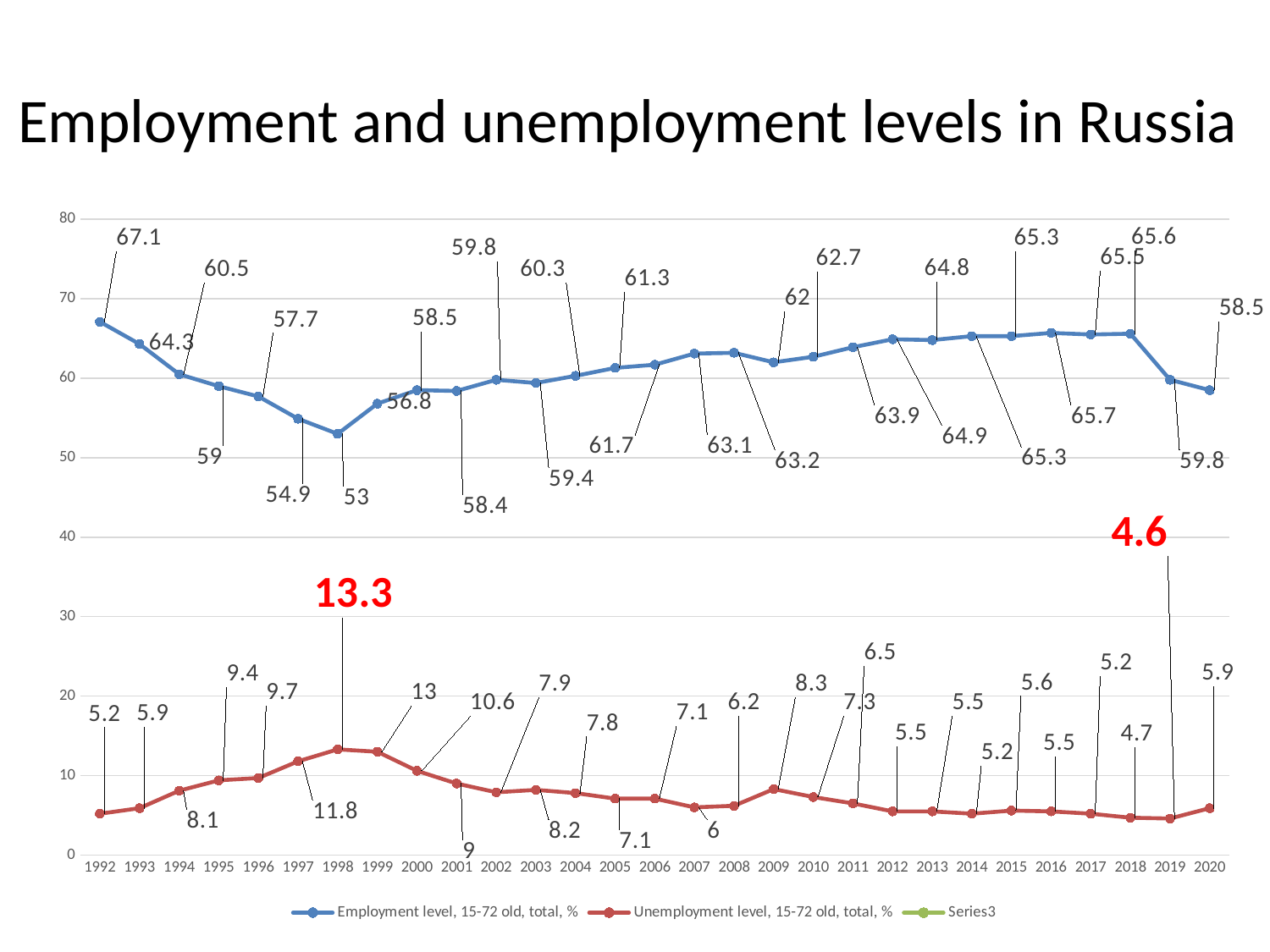
Did the employment level rise or fall from 1992 to 1998? Fall In which year was the employment level lowest? 1998 What was the unemployment level in 1998? 13.3 What kind of chart is shown on the slide? Line chart What was the unemployment level in 2020? 5.9 Which year had the higher unemployment level, 2008 or 2009? 2009 By how much did the unemployment level change from 2019 to 2020? 1.3 What was the employment level in Russia in 1992? 67.1 In which year was the unemployment level lowest? 2019 In which year was the employment level highest? 1992 What is the difference between the employment level in 1992 and in 1998? 14.1 How many series does the legend list? 3